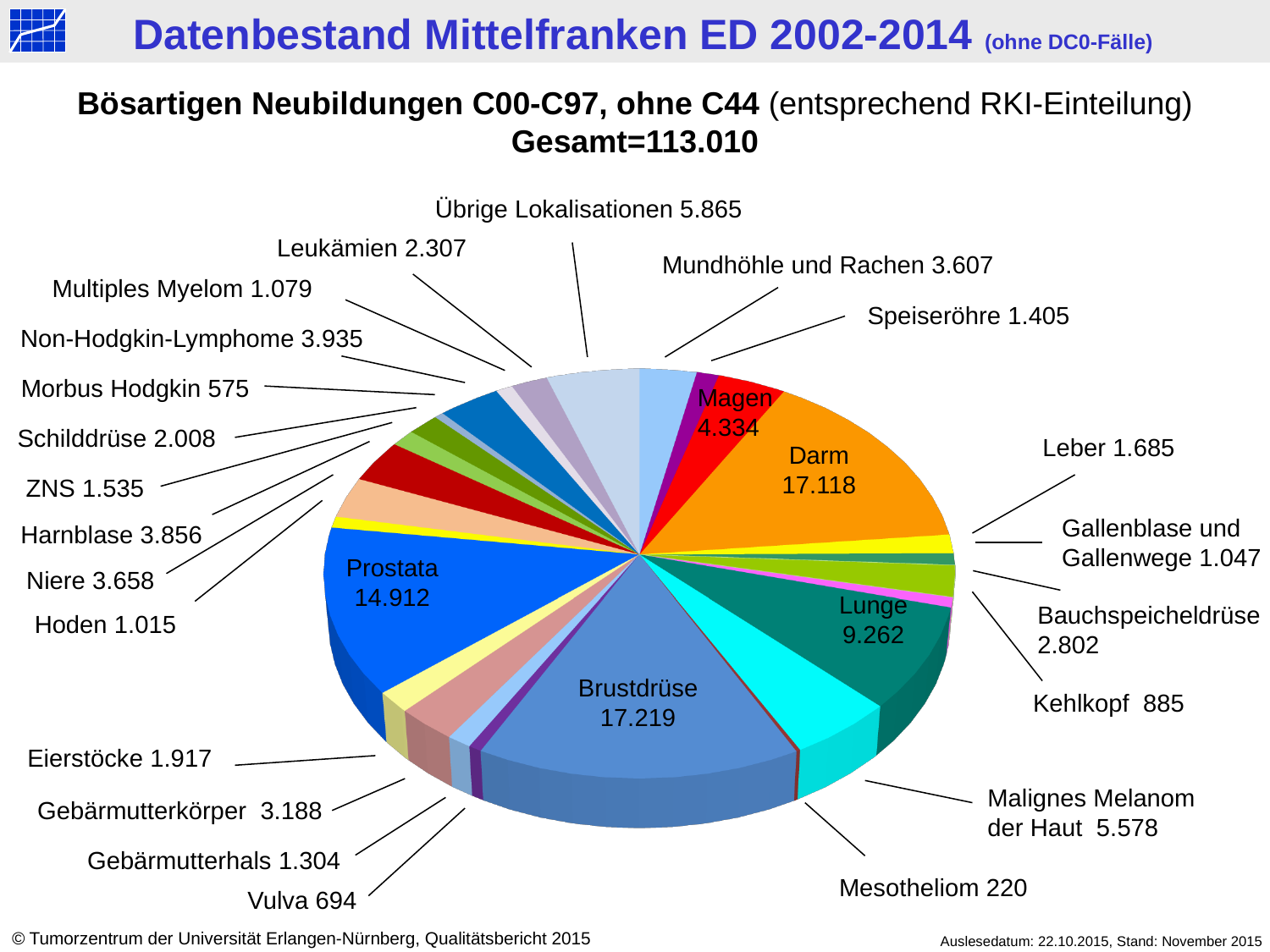
What is the value for Prostata in the pie chart? 14.912 Which is larger, the value for Lunge or the value for Magen? Lunge What total (Gesamt) is stated for the pie chart? 113.010 Which category has the largest slice in the pie chart? Brustdrüse How many categories (slices) are labelled in the pie chart? 27 Which category has the smallest slice in the pie chart? Mesotheliom What is the difference between the values for Brustdrüse and Darm? 101 What is the value for Malignes Melanom der Haut? 5.578 What is the value for Darm in the pie chart? 17.118 What type of chart is shown on the slide? Pie chart What is the difference between the values for Prostata and Lunge? 5.650 What is the value for Gebärmutterkörper? 3.188